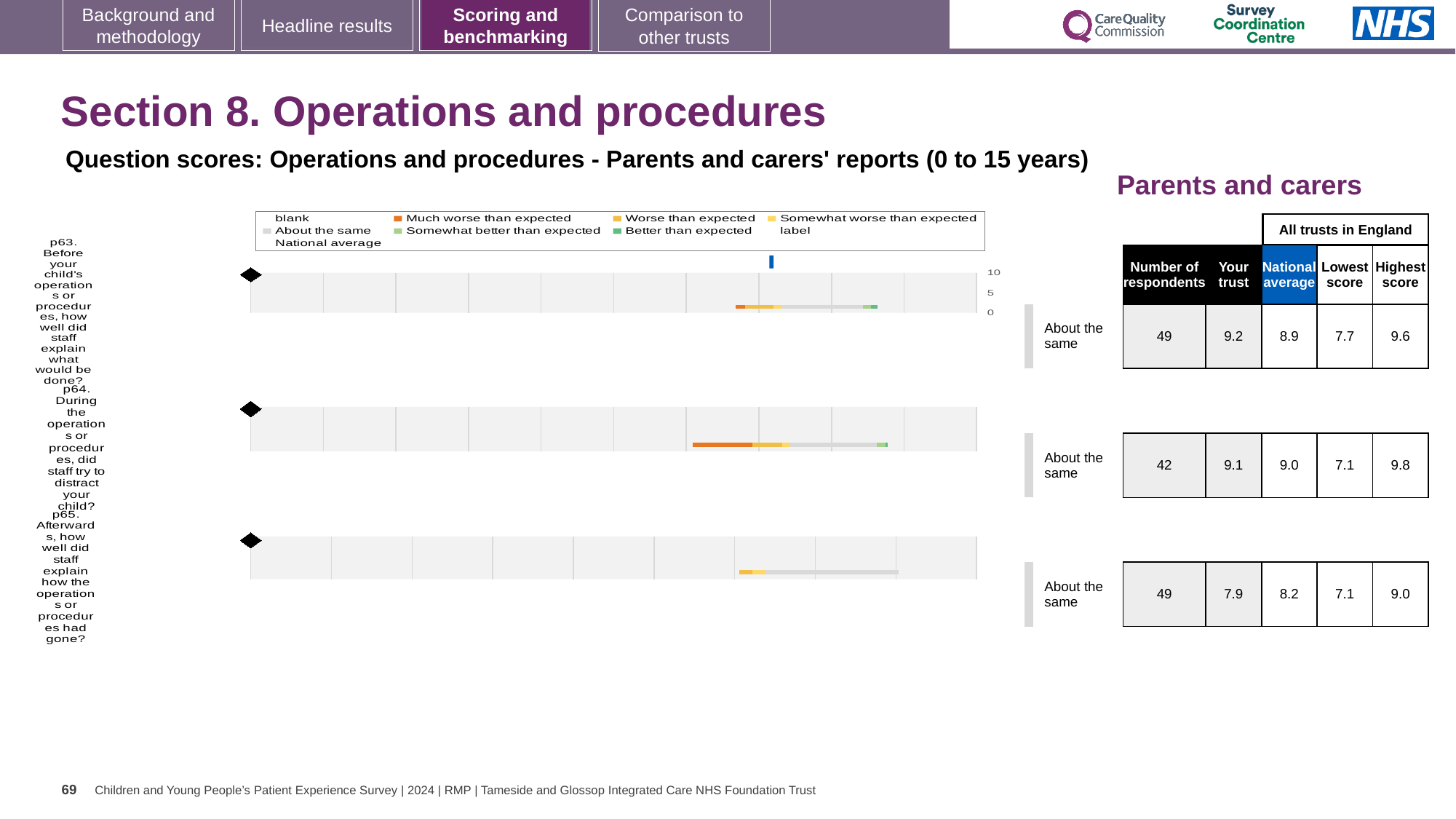
For p63, which is larger: the 'Your trust' score or the national average? Your trust How many questions are plotted on this slide? 3 What is the difference between the national average and the 'Your trust' score for p65? 0.3 Which question has the highest 'Highest score' value across all trusts in England? p64 What kind of chart is used to show the question scores? Bar chart What is the 'Your trust' score for p63 (Before your child's operations or procedures, how well did staff explain what would be done?)? 9.2 Which of the three questions has the lowest 'Your trust' score? p65 What is the national average score for p64 (During the operations or procedures, did staff try to distract your child?)? 9.0 What is the lowest score across all trusts in England for p65 (Afterwards, how well did staff explain how the operations or procedures had gone?)? 7.1 How many respondents answered question p64? 42 What benchmark category is shown for p64? About the same What is the highest score across all trusts in England for p64? 9.8